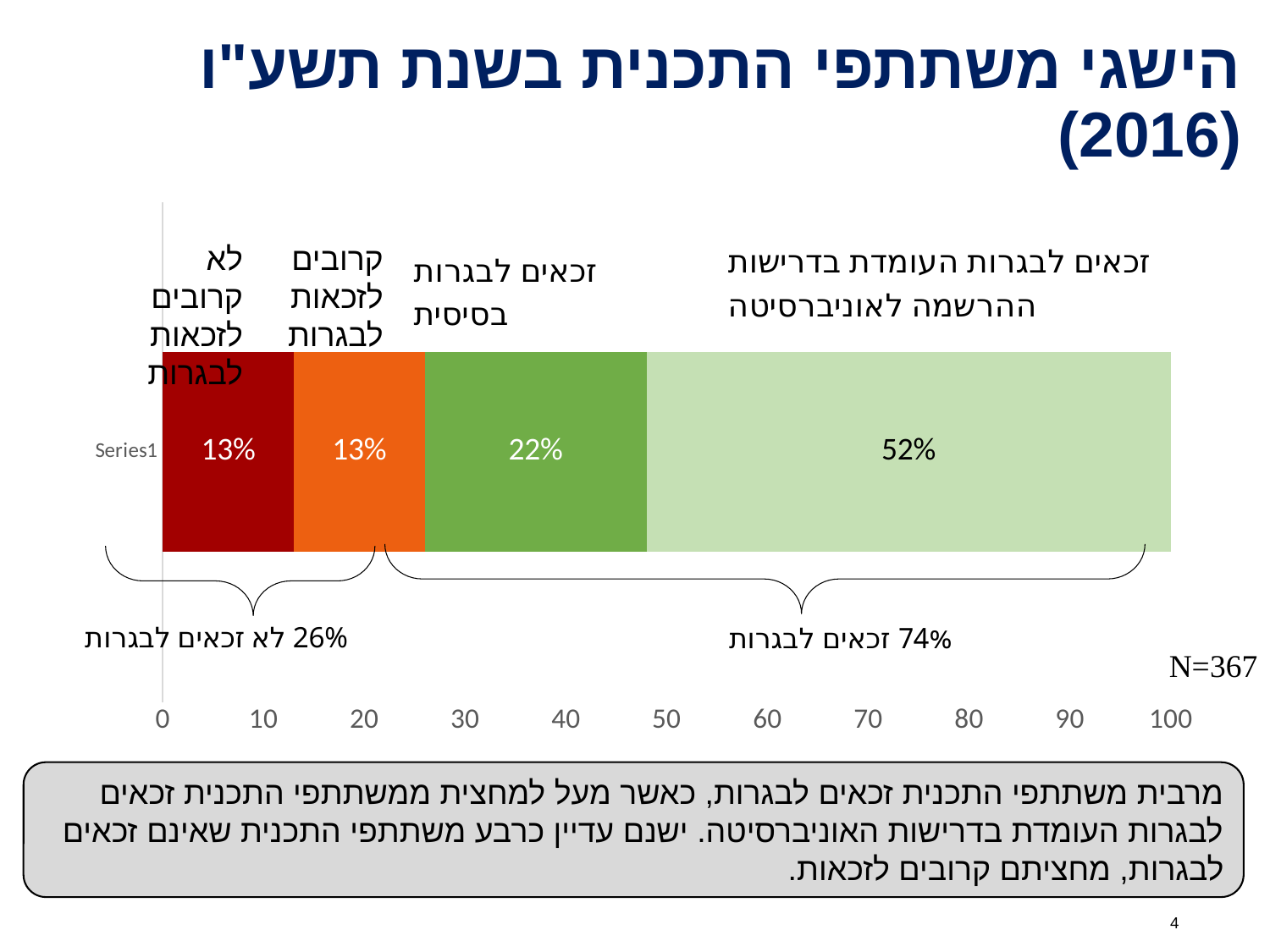
What is the combined share of the segments labelled as eligible for bagrut ("זכאים לבגרות")? 74% Which segment of the bar is the largest? זכאים לבגרות העומדת בדרישות ההרשמה לאוניברסיטה What kind of chart is shown on the slide? Stacked bar chart What percentage of participants are labelled "זכאים לבגרות בסיסית"? 22% Which is larger: the "זכאים לבגרות בסיסית" segment or the "קרובים לזכאות לבגרות" segment? זכאים לבגרות בסיסית What is the combined share of the two segments labelled as not eligible for bagrut ("לא זכאים לבגרות")? 26% What is the maximum value shown on the horizontal axis? 100 How many segments make up the stacked bar? 4 What percentage of participants are labelled "זכאים לבגרות העומדת בדרישות ההרשמה לאוניברסיטה"? 52% What is the sample size (N) shown on the slide? N=367 What percentage of participants are labelled "לא קרובים לזכאות לבגרות"? 13% What is the difference between the "זכאים לבגרות העומדת בדרישות ההרשמה לאוניברסיטה" segment and the "זכאים לבגרות בסיסית" segment? 30%